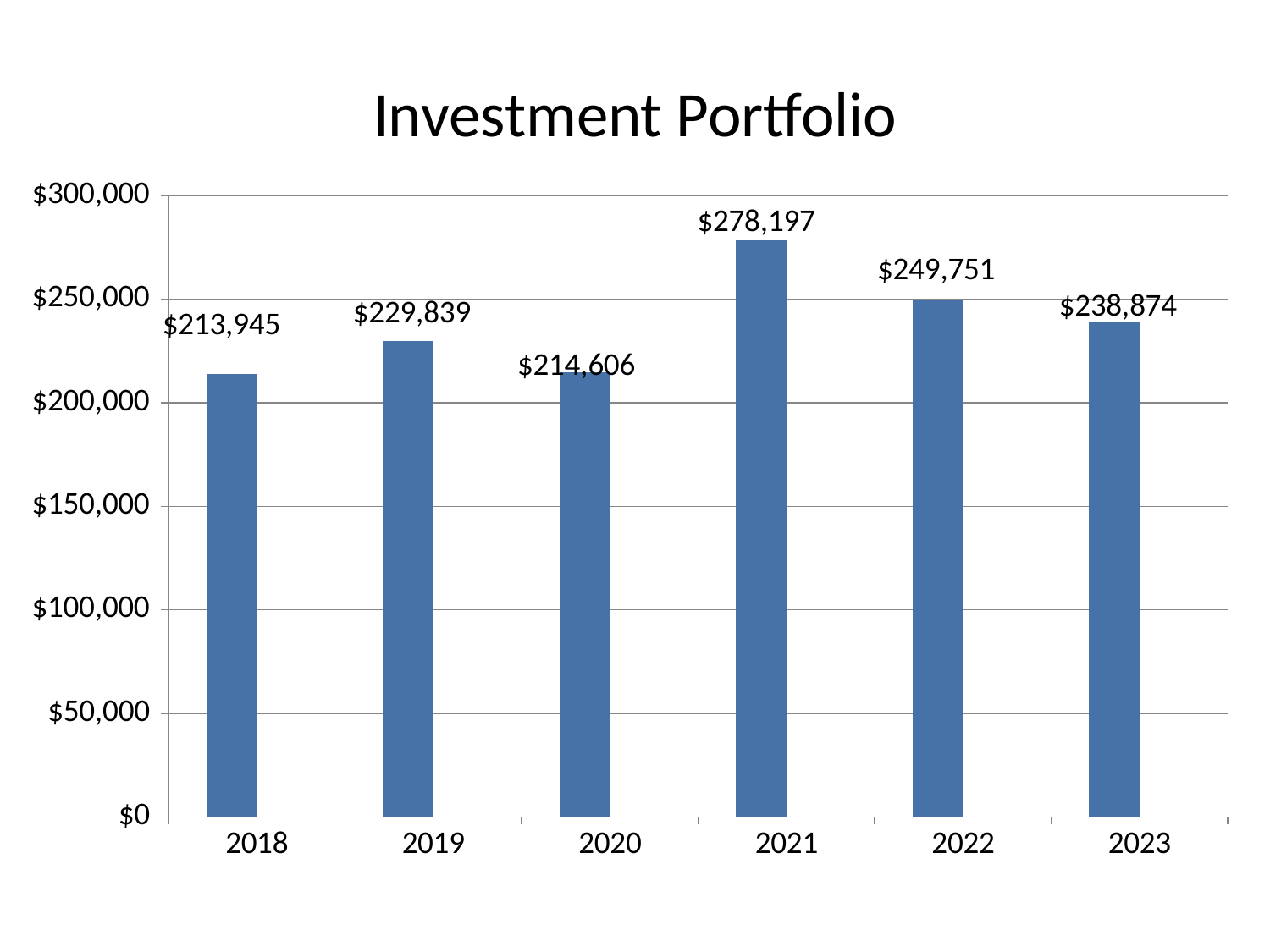
What kind of chart is shown on the slide? Bar chart How many years are shown on the chart? 6 Is the value for 2021 greater or less than $250,000? greater Which year has the lowest investment portfolio value? 2018 What is the value of the investment portfolio in 2018? $213,945 What is the difference between the 2021 and 2018 investment portfolio values? $64,252 What is the title of the chart? Investment Portfolio What is the difference between the 2022 and 2023 investment portfolio values? $10,877 What is the value of the investment portfolio in 2023? $238,874 Which year has a larger investment portfolio value, 2019 or 2022? 2022 What is the value of the investment portfolio in 2021? $278,197 Which year has the highest investment portfolio value? 2021